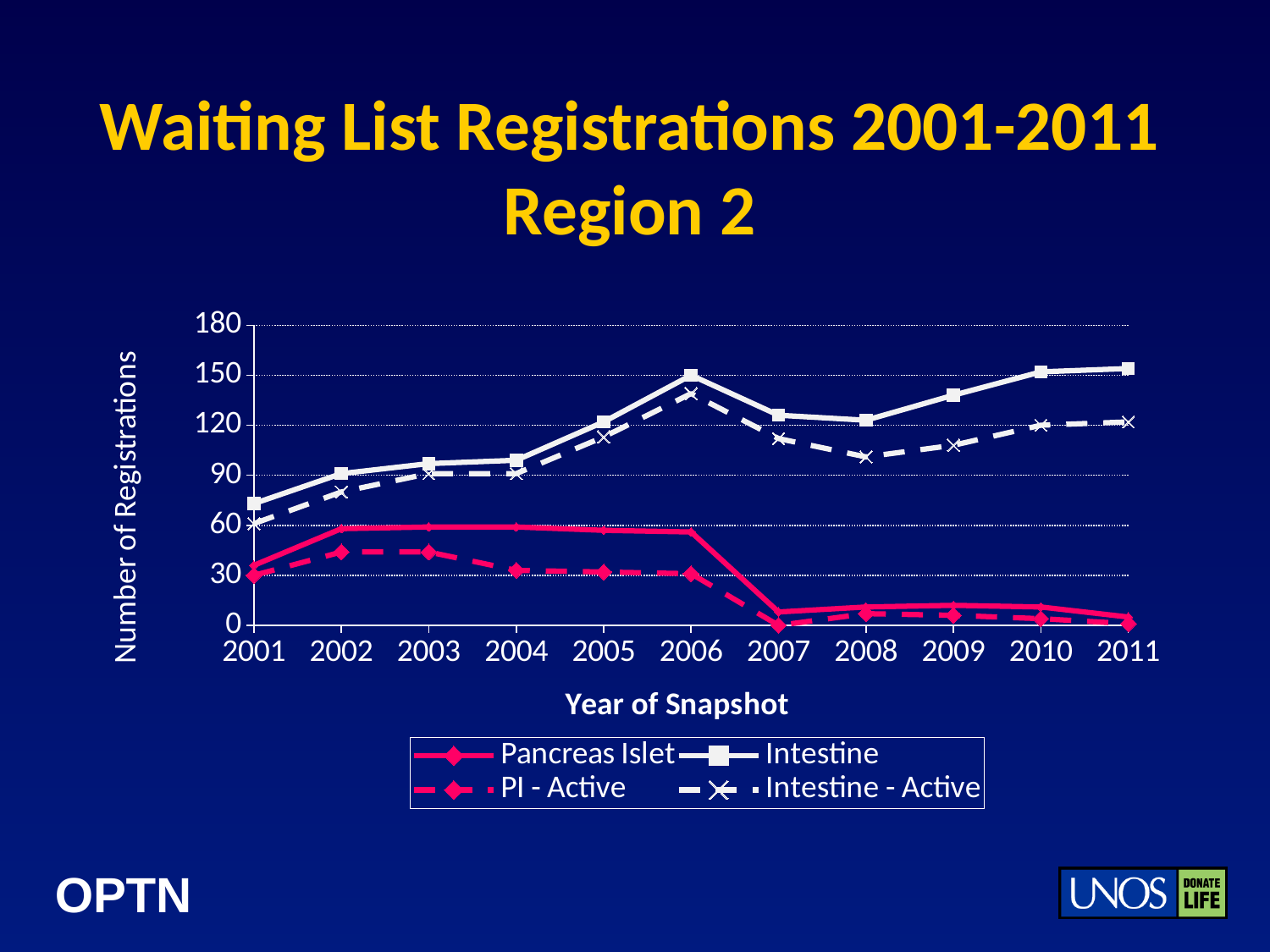
In 2006, which series has the larger value, Intestine or Pancreas Islet? Intestine Is the value for Intestine in 2001 greater or less than 90? less What is the title of the y axis? Number of Registrations Is the value for Intestine in 2009 greater or less than 120? greater How many series does the legend list? 4 Does the Intestine series rise or fall from 2001 to 2006? rise Is the value for Intestine - Active in 2008 greater or less than 120? less How many years are plotted along the x axis? 11 What is the value for PI - Active in 2007? 0 What kind of chart is shown on the slide? line chart In which year is the Intestine - Active series at its highest? 2006